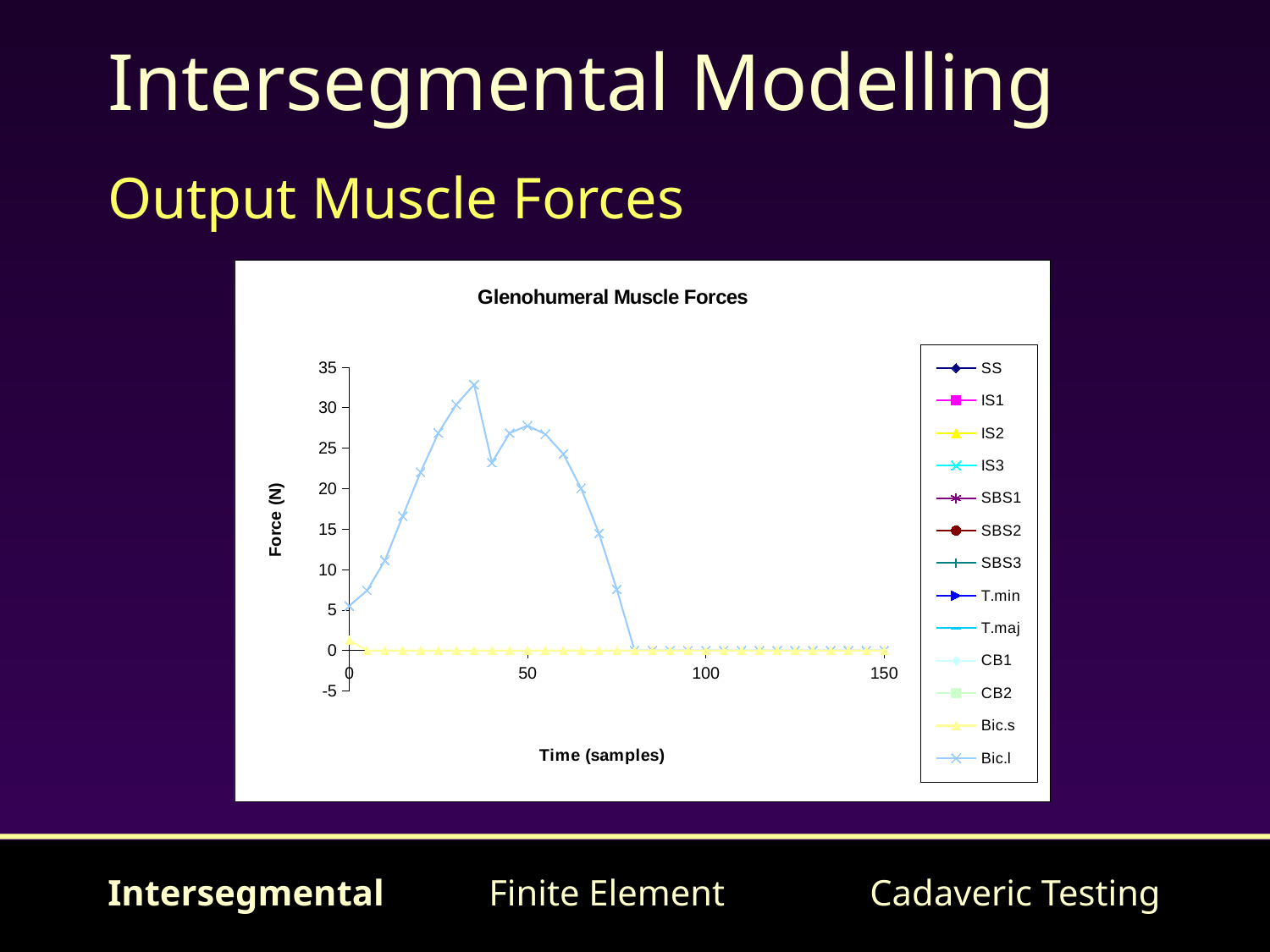
What is the title of the chart? Glenohumeral Muscle Forces Is the peak value of the Bic.l series greater or less than 30? greater How many series does the legend of the chart list? 13 Is the value of the Bic.l series at time 100 greater or less than 5? less Is the value of the Bic.l series at time 50 greater or less than 20? greater Is the Bic.l series larger at time 35 or at time 50? time 35 What kind of chart is shown on the slide? line chart Which series reaches the highest force in the chart? Bic.l Does the Bic.l series rise or fall between time 0 and time 35? rise Does the Bic.l series rise or fall between time 50 and time 80? fall What is the label of the x axis of the chart? Time (samples)